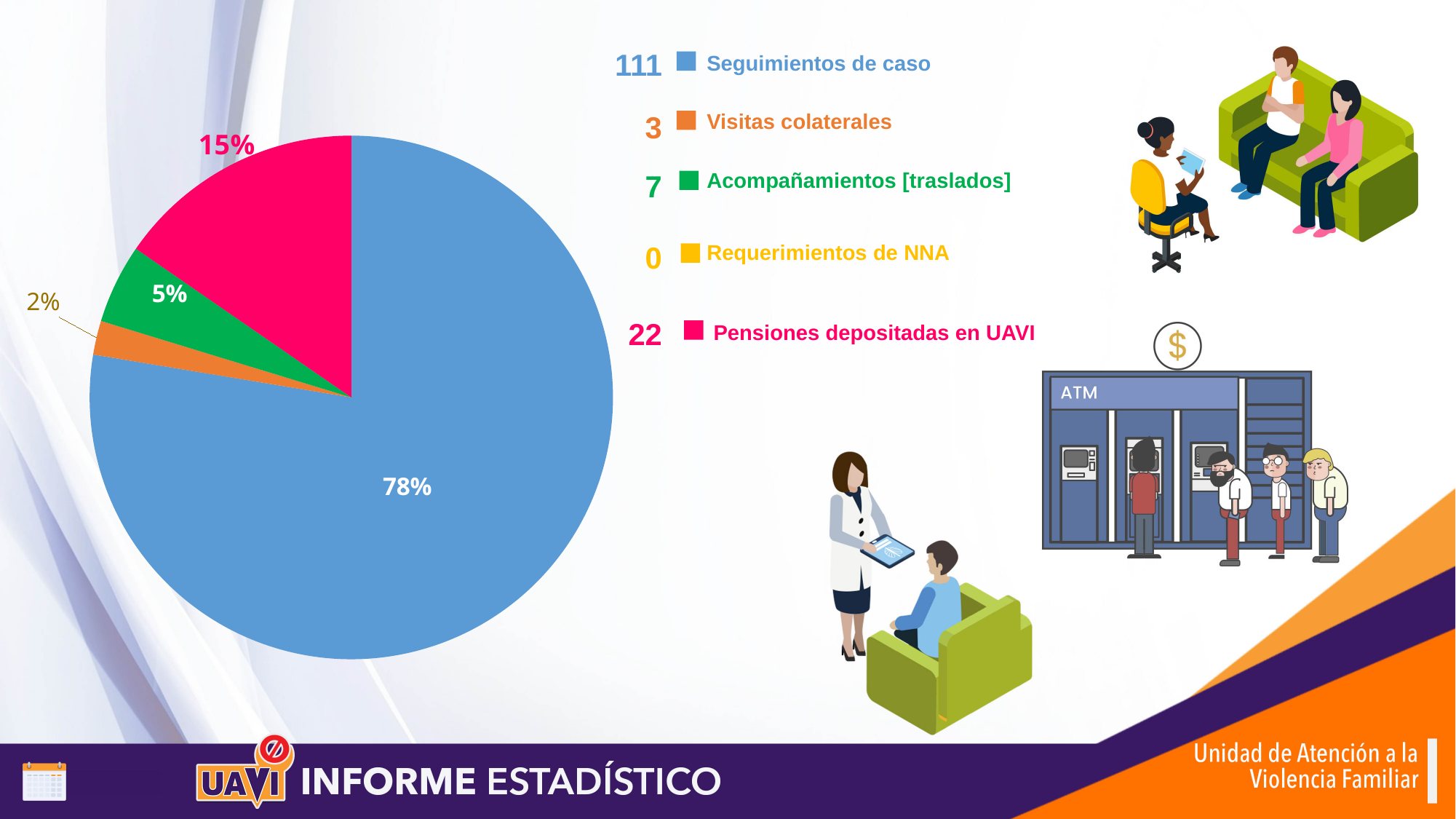
How many Seguimientos de caso are listed in the legend? 111 What percentage of the pie does Pensiones depositadas en UAVI represent? 15% Which category has the smallest value in the legend? Requerimientos de NNA How many Requerimientos de NNA are listed in the legend? 0 What percentage of the pie does Visitas colaterales represent? 2% What is the difference between the number of Seguimientos de caso and the number of Pensiones depositadas en UAVI? 89 What percentage of the pie does Acompañamientos [traslados] represent? 5% Which category has the largest slice of the pie? Seguimientos de caso How many categories does the legend list? 5 How many Pensiones depositadas en UAVI are listed in the legend? 22 What kind of chart is shown on the slide? pie chart